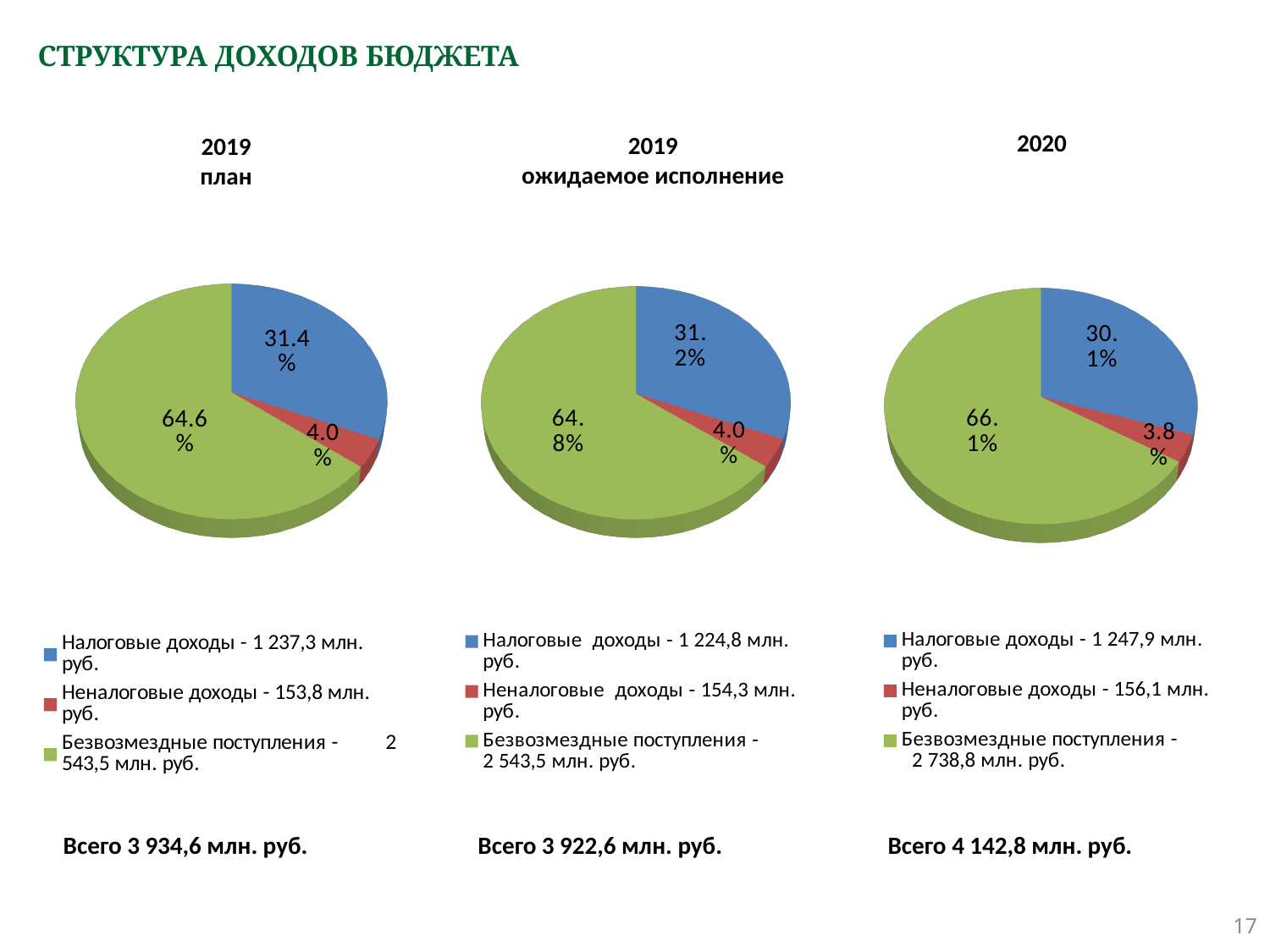
In the "2020" chart, what share of the pie is labelled for Налоговые доходы? 30.1% In the "2019 план" chart, what share of the pie is labelled for Безвозмездные поступления? 64.6% What kind of chart is used for the "2019 план" chart? pie chart In the "2019 план" chart, which category has the smallest slice? Неналоговые доходы In the "2019 план" chart, what share of the pie is labelled for Налоговые доходы? 31.4% In the "2020" chart, what is the difference between the shares of Безвозмездные поступления and Налоговые доходы? 36.0% How many slices does the "2019 ожидаемое исполнение" pie chart have? 3 In the "2020" chart, what colour is the slice for Безвозмездные поступления? green In the "2020" chart, which category has the largest slice? Безвозмездные поступления